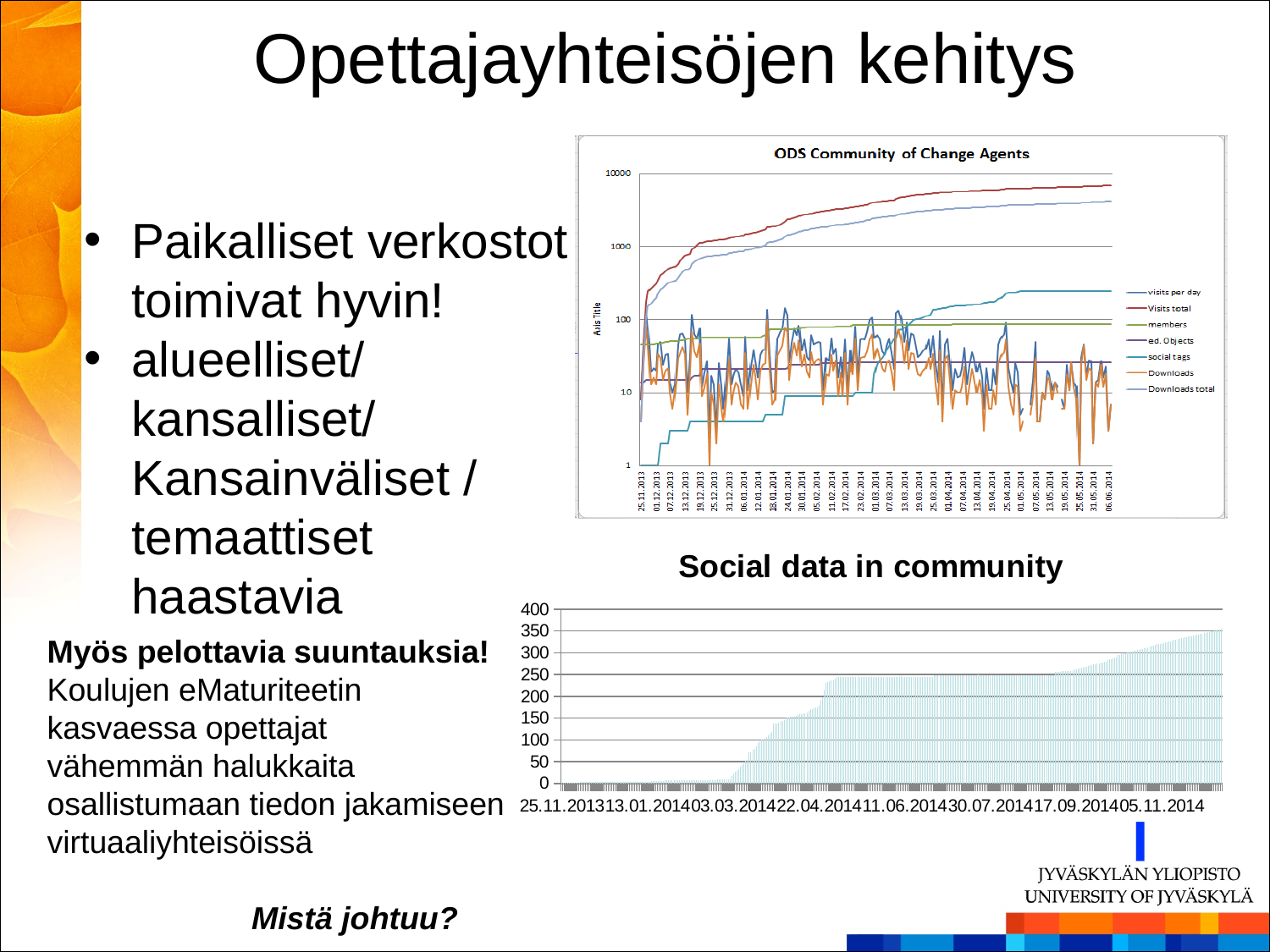
In the 'Social data in community' chart, is the value at the last date greater or less than 300? greater What kind of chart is the 'Social data in community' chart? bar chart What is the highest value shown on the y axis of the 'Social data in community' chart? 400 How many series does the legend of the 'ODS Community of Change Agents' chart list? 7 What is the title of the upper chart on the slide? ODS Community of Change Agents In the 'ODS Community of Change Agents' chart, which series has the highest value at the end of the period? Visits total In the 'Social data in community' chart, do the values rise or fall along the x axis? rise What kind of chart is the 'ODS Community of Change Agents' chart? line chart In the 'ODS Community of Change Agents' chart, does the 'Visits total' series rise or fall over time? rise In the 'ODS Community of Change Agents' chart, which is larger at the end of the period: 'Visits total' or 'Downloads total'? Visits total In the 'ODS Community of Change Agents' chart, is the final value of 'Visits total' greater or less than 1000? greater In the 'Social data in community' chart, is the value at 25.11.2013 greater or less than 50? less